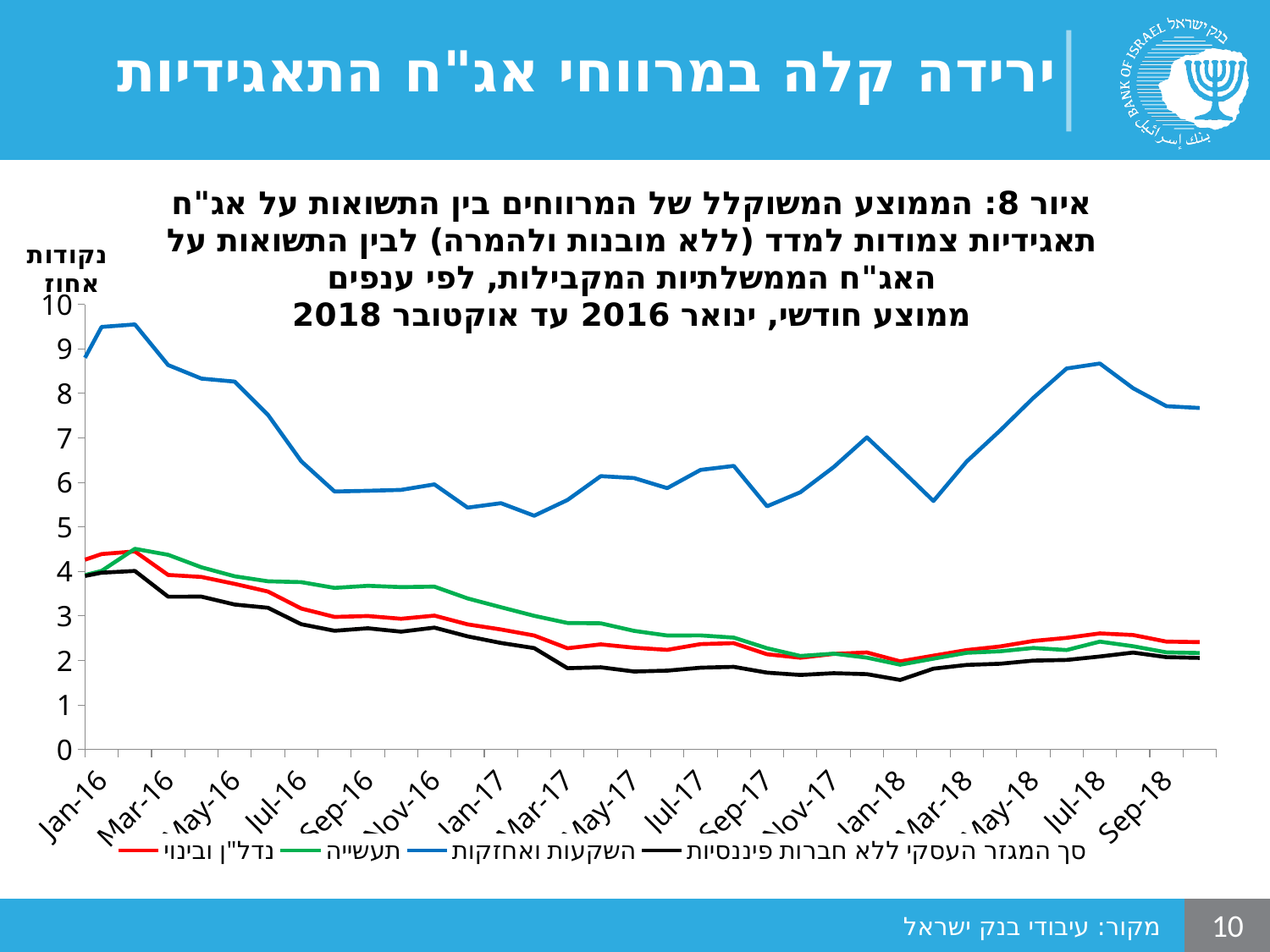
Which series has the highest value at Jan-16? השקעות ואחזקות Is the value for השקעות ואחזקות at Jan-16 greater or less than 8? greater What is the unit label shown on the y axis? נקודות אחוז Is the value for נדל"ן ובינוי at Sep-18 greater or less than 3? less Which series has the lowest value at Sep-18? סך המגזר העסקי ללא חברות פיננסיות Which series is plotted with the blue line? השקעות ואחזקות Is the value for השקעות ואחזקות at Mar-17 greater or less than 6? less Does the value for סך המגזר העסקי ללא חברות פיננסיות rise or fall from Jan-16 to Mar-17? fall How many series does the legend list? 4 What type of chart is shown on the slide? line chart